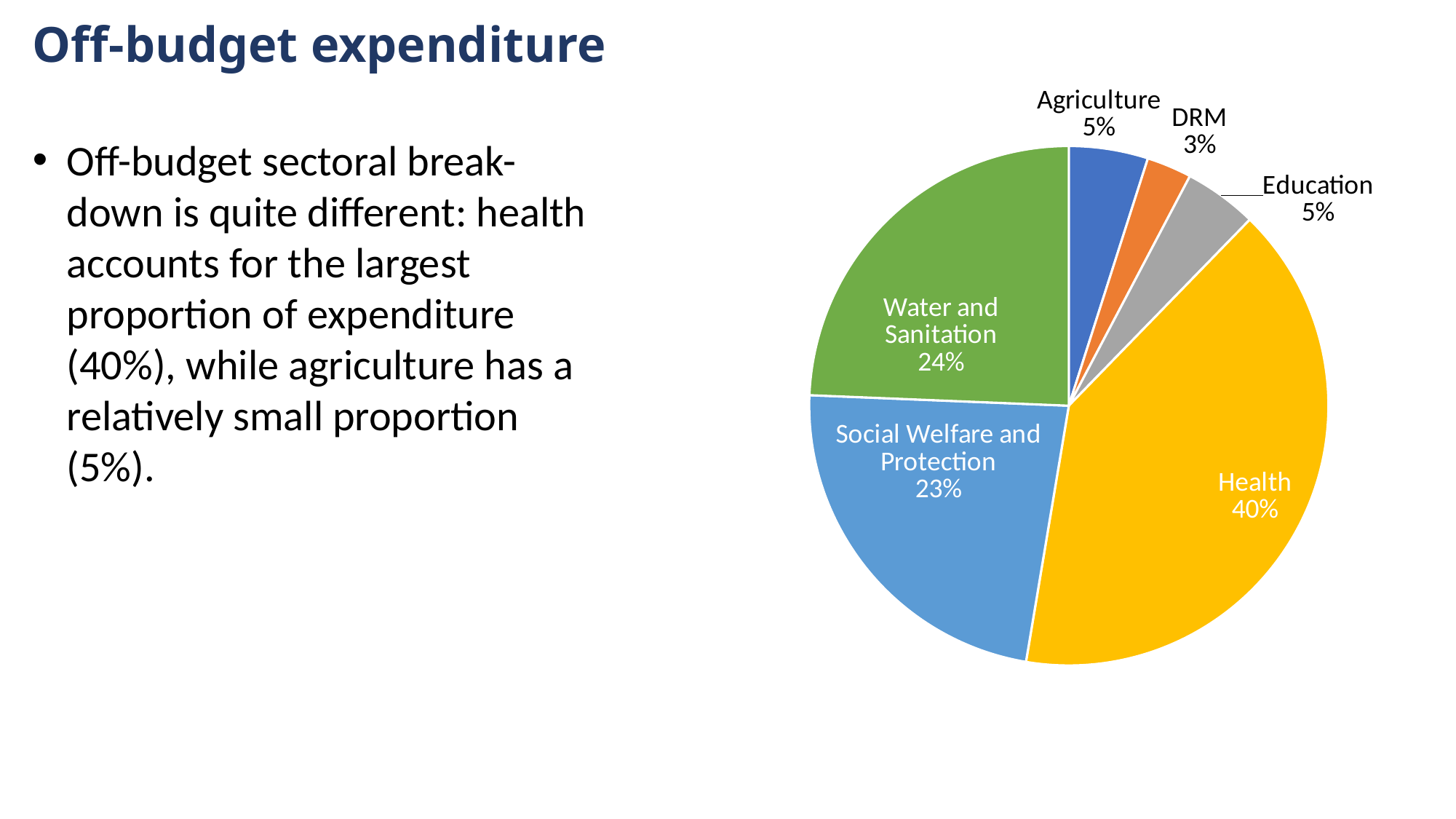
How many sectors are shown in the pie chart? 6 Which sector has the largest share of off-budget expenditure? Health What share of off-budget expenditure does Agriculture account for? 5% What colour is the Health slice in the pie chart? Yellow What share of off-budget expenditure does Social Welfare and Protection account for? 23% What kind of chart is shown on the slide? Pie chart What is the difference in percentage points between the Health share and the Water and Sanitation share? 16 What share of off-budget expenditure does DRM account for? 3% Which sector has the smallest share of off-budget expenditure? DRM Which has a larger share, Social Welfare and Protection or Education? Social Welfare and Protection